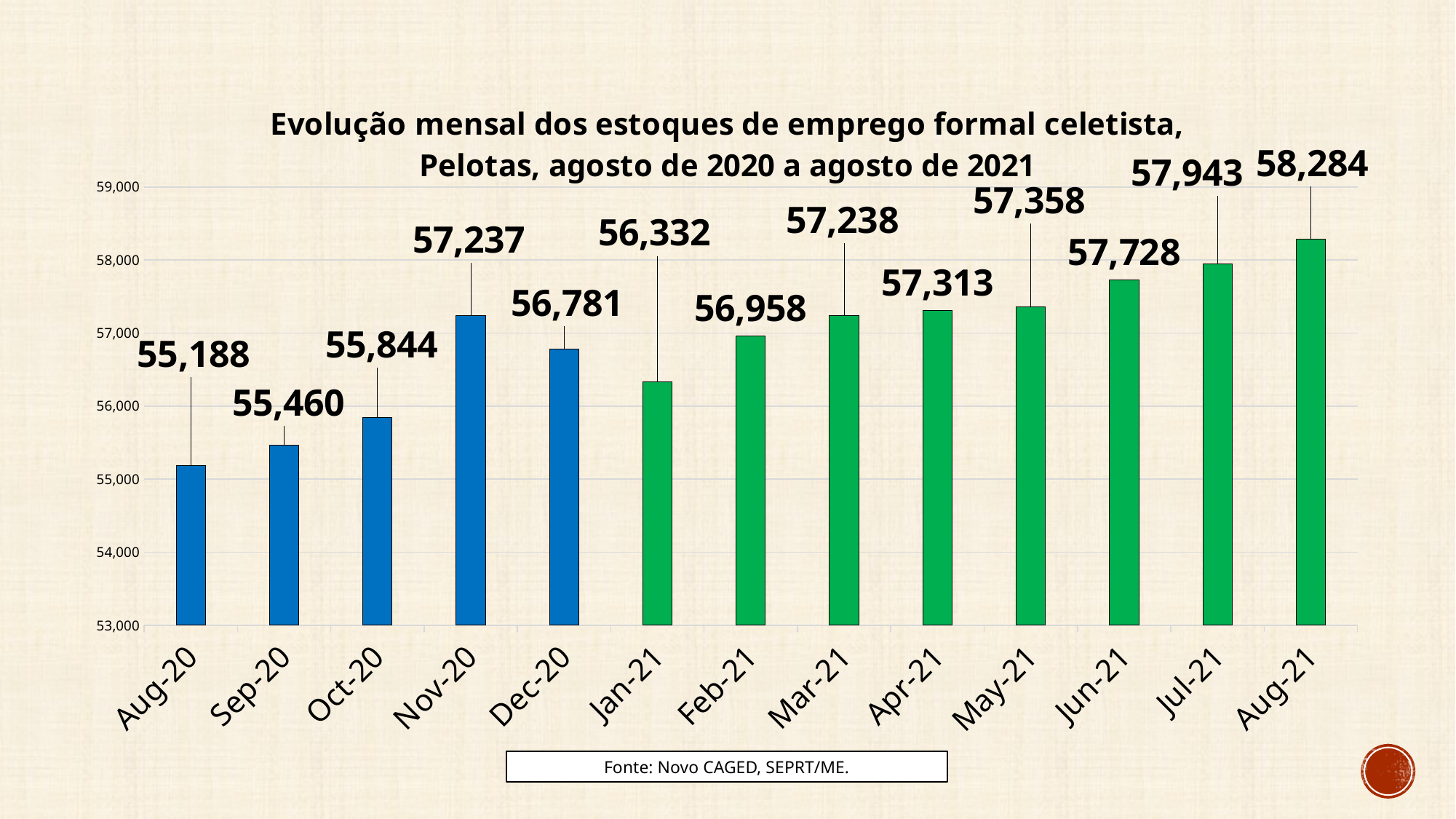
What is the difference between the values for Aug-21 and Aug-20? 3,096 What is the value for Jan-21? 56,332 What is the value for Nov-20? 57,237 Which month has the highest value? Aug-21 What is the value for May-21? 57,358 Which is larger, the value for Dec-20 or the value for Jan-21? Dec-20 What kind of chart is shown on the slide? bar chart How many months are shown on the x axis? 13 What colour are the bars for the 2021 months? green What is the difference between the values for Nov-20 and Dec-20? 456 Which month has the lowest value? Aug-20 Is the value for Oct-20 greater or less than 56,000? less